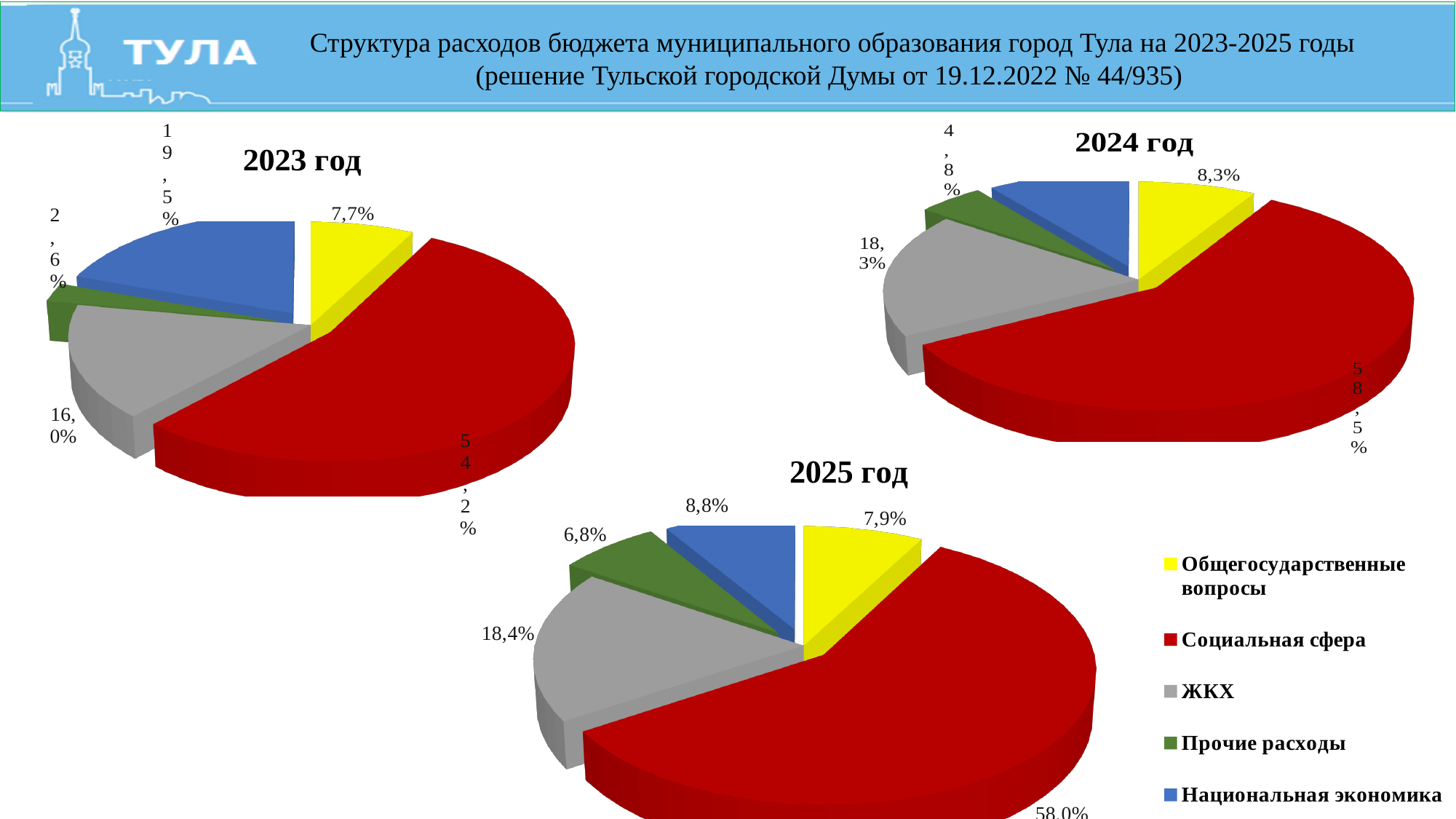
On the 2023 год chart, what share is shown for Социальная сфера? 54,2% On the 2024 год chart, what share is shown for ЖКХ? 18,3% On the 2023 год chart, what share is shown for Национальная экономика? 19,5% On the 2025 год chart, what share is shown for Прочие расходы? 6,8% What type of chart is used for 2024 год? Pie chart On the 2025 год chart, which category has the largest share? Социальная сфера How many entries does the legend list? 5 Which colour represents ЖКХ in the legend? Grey How many slices does the 2025 год chart have? 5 On the 2024 год chart, which is larger: Общегосударственные вопросы or Прочие расходы? Общегосударственные вопросы On the 2023 год chart, which category has the smallest share? Прочие расходы On the 2025 год chart, what is the difference between the shares of ЖКХ and Национальная экономика? 9,6%